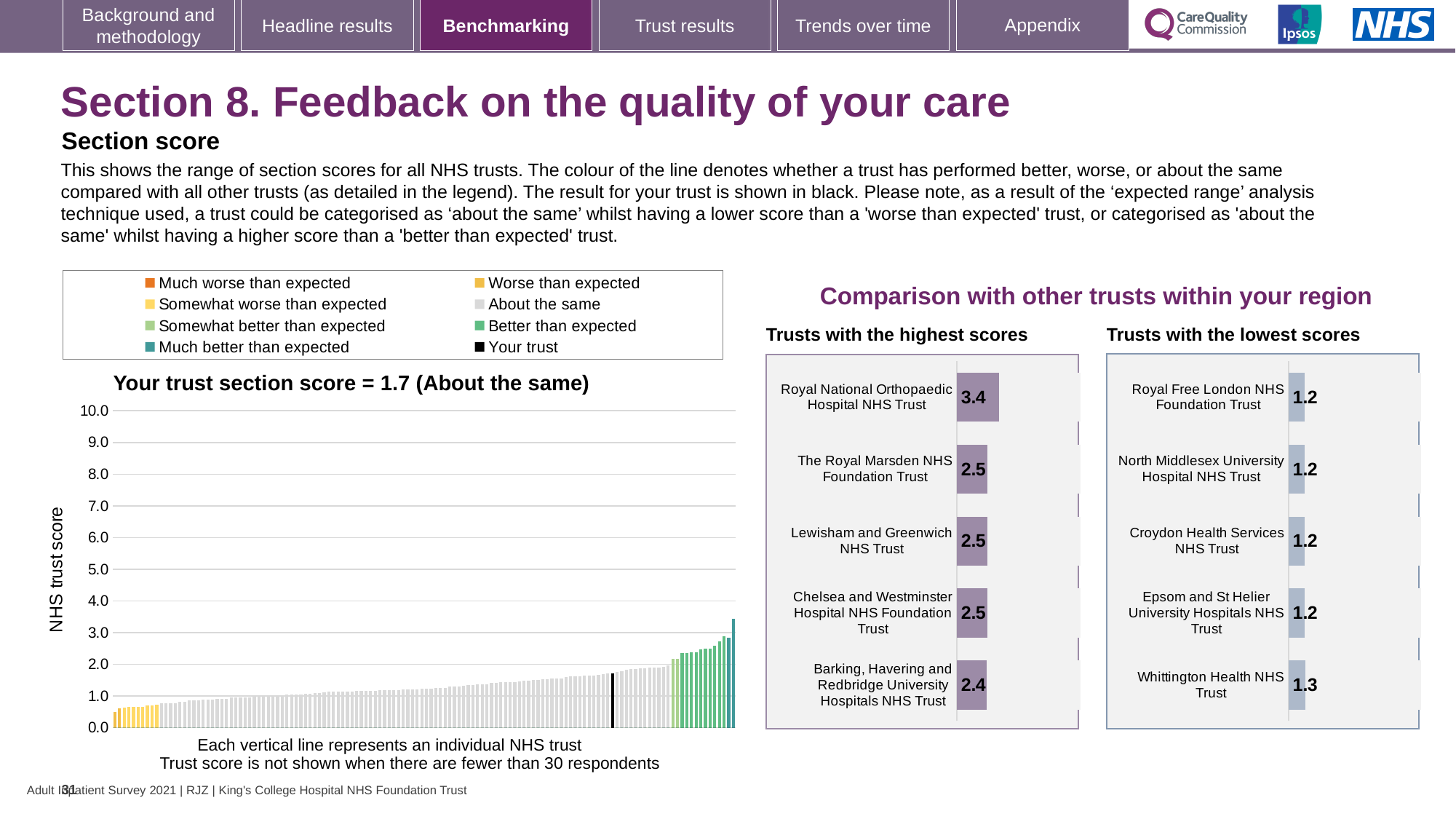
In the 'Trusts with the lowest scores' chart, how many trusts are listed? 5 In the 'Trusts with the highest scores' chart, what is the score for Royal National Orthopaedic Hospital NHS Trust? 3.4 Which has the larger score: Royal National Orthopaedic Hospital NHS Trust in the highest scores chart or Whittington Health NHS Trust in the lowest scores chart? Royal National Orthopaedic Hospital NHS Trust In the 'Trusts with the lowest scores' chart, which trust has the highest score? Whittington Health NHS Trust In the 'Trusts with the highest scores' chart, what is the difference between the scores of Royal National Orthopaedic Hospital NHS Trust and Barking, Havering and Redbridge University Hospitals NHS Trust? 1.0 In the 'Trusts with the highest scores' chart, which trust has the highest score? Royal National Orthopaedic Hospital NHS Trust How many entries does the legend above the 'Your trust section score' chart list? 8 In the 'Trusts with the lowest scores' chart, what is the difference between the scores of Whittington Health NHS Trust and Croydon Health Services NHS Trust? 0.1 In the 'Your trust section score' chart, do the trust scores rise or fall from left to right? rise In the 'Trusts with the highest scores' chart, what is the score for Barking, Havering and Redbridge University Hospitals NHS Trust? 2.4 In the 'Your trust section score' chart, what is the section score for your trust? 1.7 In the 'Trusts with the lowest scores' chart, what is the score for Whittington Health NHS Trust? 1.3